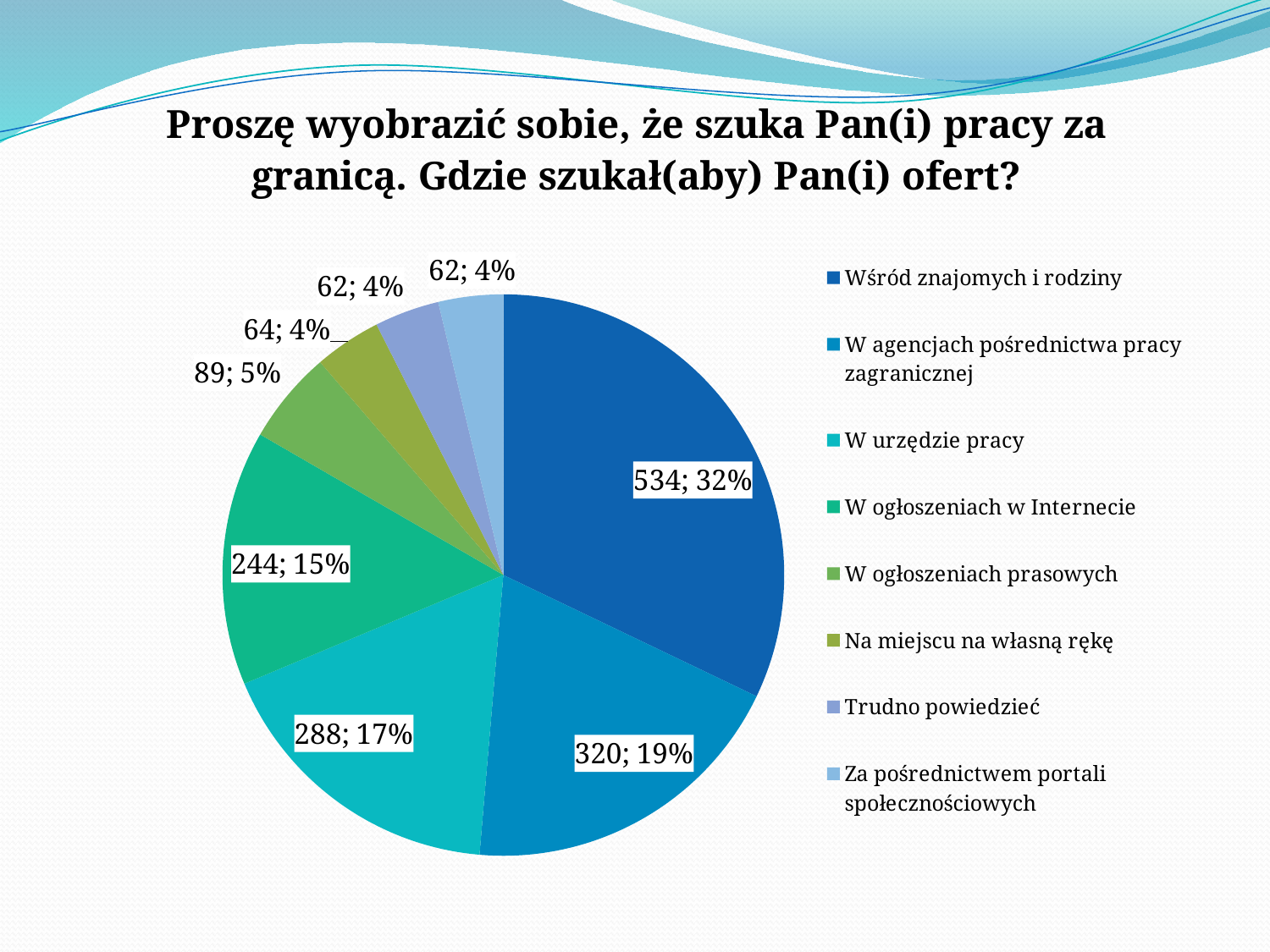
What is the difference in count between "Wśród znajomych i rodziny" and "W agencjach pośrednictwa pracy zagranicznej"? 214 What is the count for "Na miejscu na własną rękę"? 64 Which is larger, the count for "W urzędzie pracy" or for "W ogłoszeniach w Internecie"? W urzędzie pracy What is the count for "W ogłoszeniach prasowych"? 89 What percentage share does "W ogłoszeniach w Internecie" have? 15% Which category has the largest slice? Wśród znajomych i rodziny What percentage share does "W agencjach pośrednictwa pracy zagranicznej" have? 19% What is the count for "W urzędzie pracy"? 288 How many entries does the legend list? 8 What kind of chart is shown on the slide? pie chart How many slices does the pie chart have? 8 What is the count for "Wśród znajomych i rodziny"? 534